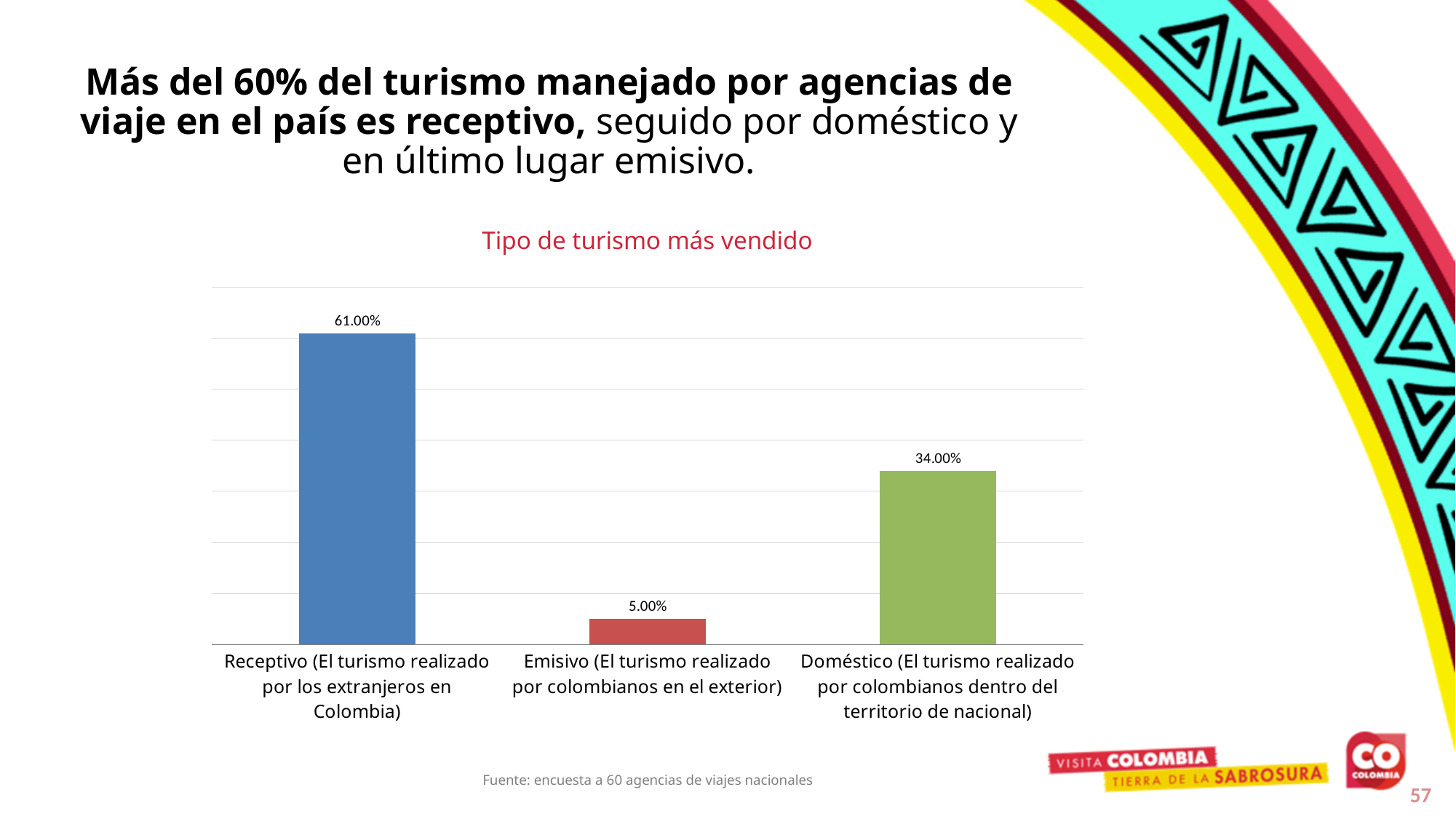
How many categories are shown in the chart? 3 What is the value for Receptivo in the chart? 61.00% What is the value for Emisivo in the chart? 5.00% Which type of tourism has the highest value? Receptivo What colour is the bar for Emisivo? Red What kind of chart is shown on the slide? Bar chart What is the title of the chart? Tipo de turismo más vendido Which is larger, the value for Doméstico or the value for Emisivo? Doméstico What is the difference between the values for Receptivo and Doméstico? 27.00% What is the difference between the values for Doméstico and Emisivo? 29.00% Which type of tourism has the lowest value? Emisivo What is the value for Doméstico in the chart? 34.00%